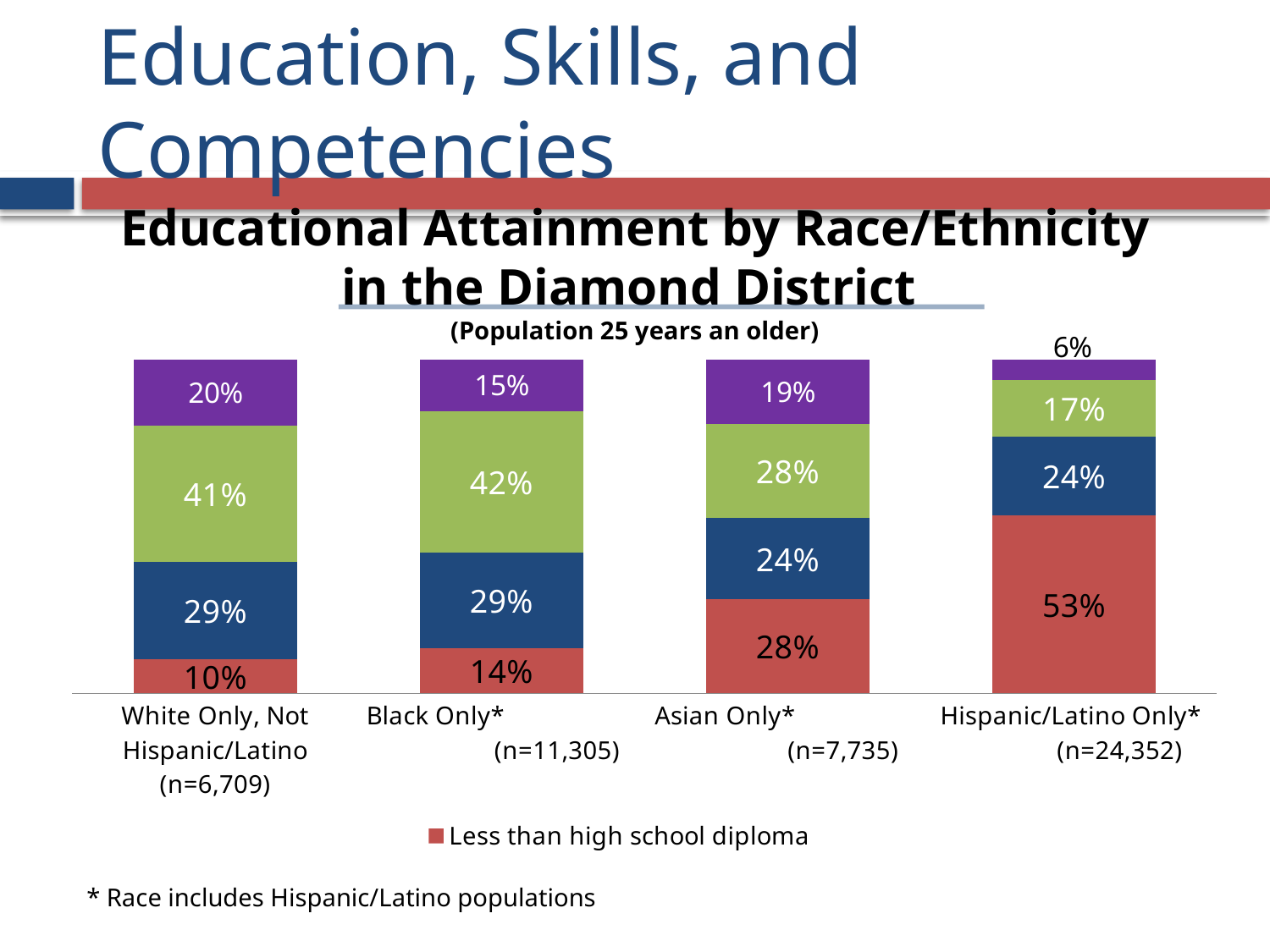
What is the value of the purple (top) segment for Hispanic/Latino Only*? 6% Which race/ethnicity group has the highest share with less than a high school diploma? Hispanic/Latino Only* What percentage of the Hispanic/Latino Only* population has less than a high school diploma? 53% How many series does the legend list? 1 What is the difference in the 'Less than high school diploma' share between Hispanic/Latino Only* and Black Only*? 39% What type of chart is shown on the slide? Stacked bar chart Which group has a larger share with less than a high school diploma, Black Only* or Asian Only*? Asian Only* What percentage of the Asian Only* population has less than a high school diploma? 28% How many race/ethnicity groups are shown on the chart? 4 What is the total of the stacked bar for Black Only*? 100% Which race/ethnicity group has the lowest share with less than a high school diploma? White Only, Not Hispanic/Latino What percentage of the White Only, Not Hispanic/Latino population has less than a high school diploma? 10%